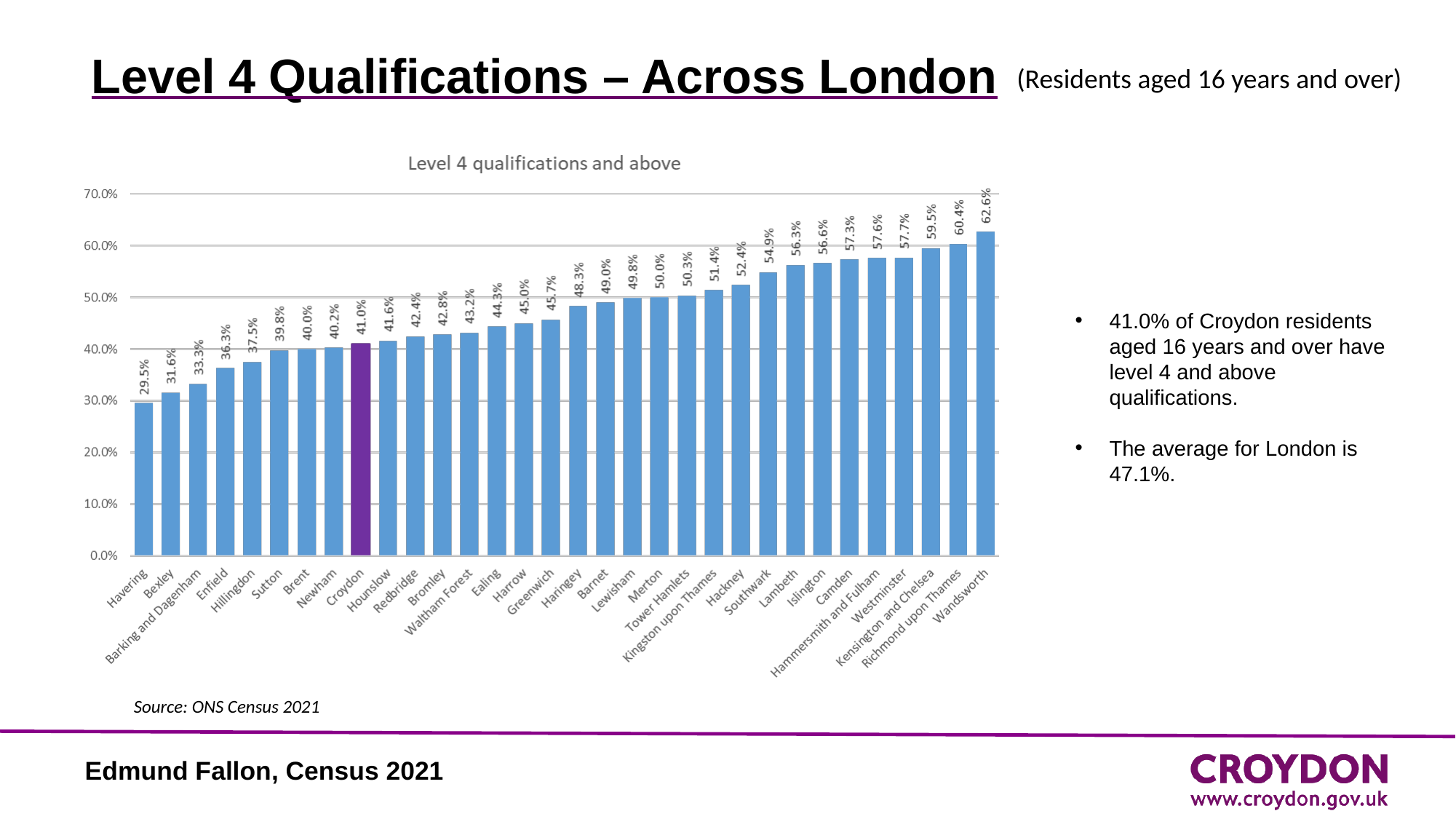
Which borough has the highest value? Wandsworth What is the value for Havering? 29.5% What is the value for Wandsworth? 62.6% What kind of chart is shown? Bar chart What is the value for Croydon? 41.0% How many boroughs are shown in the chart? 32 Which bar is highlighted in a different colour (purple)? Croydon What is the difference between the values for Wandsworth and Havering? 33.1 percentage points What is the difference between the values for Wandsworth and Croydon? 21.6 percentage points Which has a larger value, Hackney or Harrow? Hackney Which borough has the lowest value? Havering What is the value for Kingston upon Thames? 51.4%